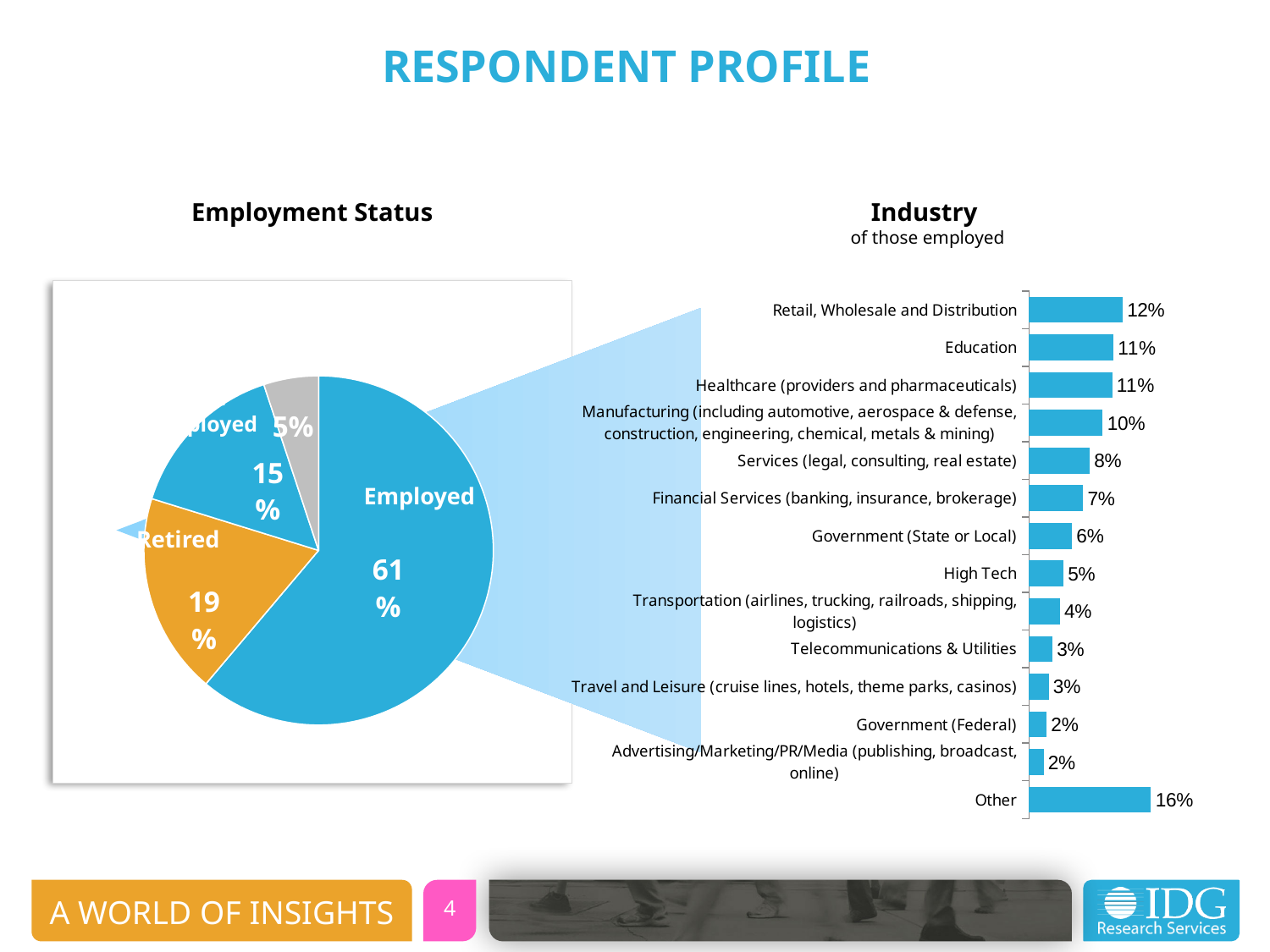
In the Employment Status chart, what share of respondents are Retired? 19% In the Employment Status chart, what is the difference between the Employed and Retired shares? 42% What kind of chart is the Industry chart? Bar chart What kind of chart is the Employment Status chart? Pie chart In the Industry chart, which is larger: Services (legal, consulting, real estate) or Government (State or Local)? Services (legal, consulting, real estate) In the Industry chart, which category has the highest value? Other In the Employment Status chart, what share of respondents are Employed? 61% In the Industry chart, what is the value for High Tech? 5% In the Industry chart, what is the value for Government (Federal)? 2% In the Industry chart, what is the difference between Education and Financial Services (banking, insurance, brokerage)? 4% In the Industry chart, what is the value for Retail, Wholesale and Distribution? 12% How many categories are shown in the Industry chart? 14